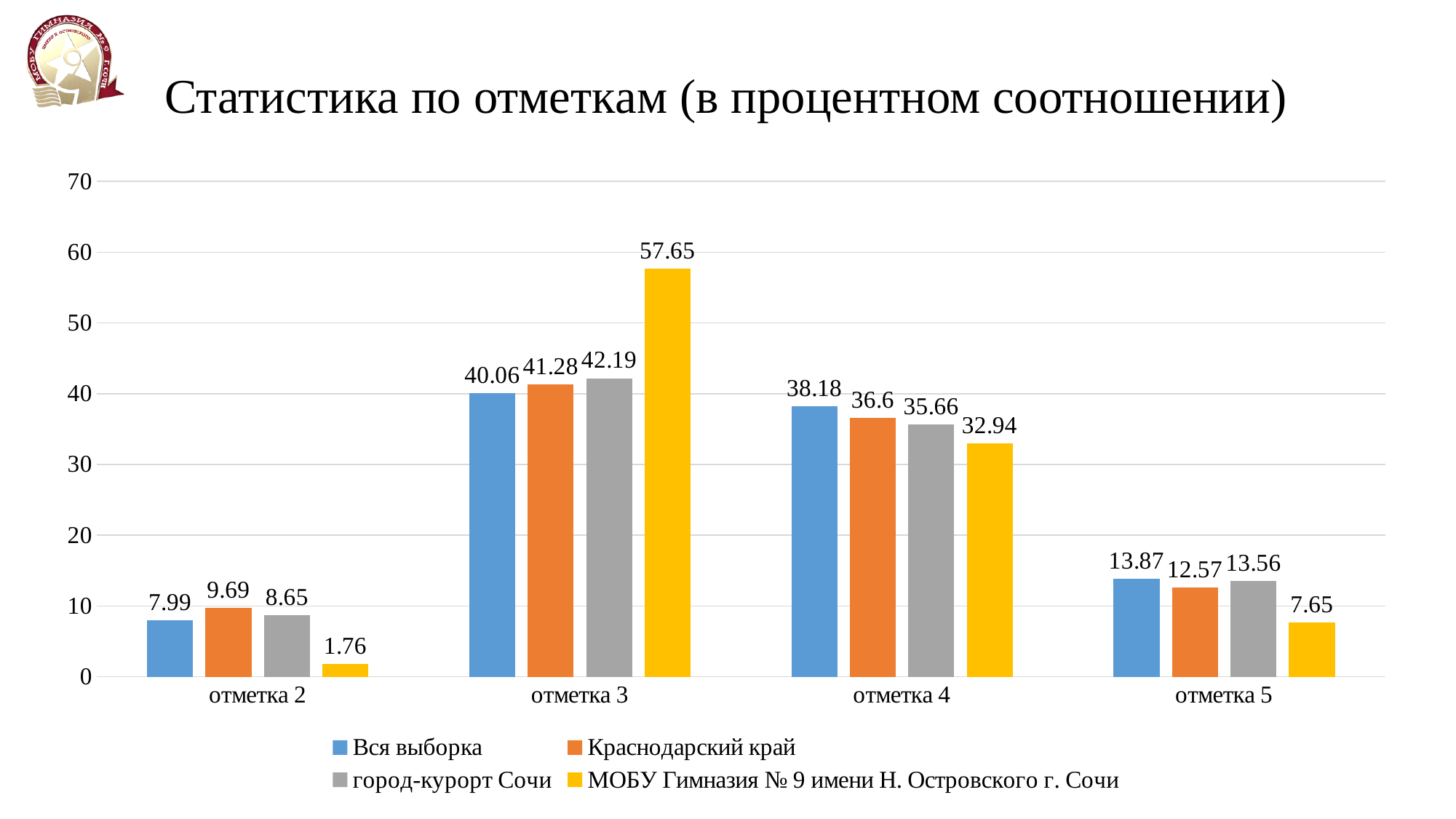
What kind of chart is shown on the slide? bar chart What is the difference between the МОБУ Гимназия № 9 value and the Вся выборка value at отметка 3? 17.59 Which is larger at отметка 4: Вся выборка or МОБУ Гимназия № 9 имени Н. Островского г. Сочи? Вся выборка What is the value for Краснодарский край at отметка 2? 9.69 How many categories are shown on the x axis? 4 What is the value for город-курорт Сочи at отметка 5? 13.56 Which series has the highest value at отметка 3? МОБУ Гимназия № 9 имени Н. Островского г. Сочи Is the value for город-курорт Сочи at отметка 3 greater or less than 40? greater Which series has the lowest value at отметка 2? МОБУ Гимназия № 9 имени Н. Островского г. Сочи How many series does the legend list? 4 What is the value for МОБУ Гимназия № 9 имени Н. Островского г. Сочи at отметка 3? 57.65 What is the value for Вся выборка at отметка 4? 38.18